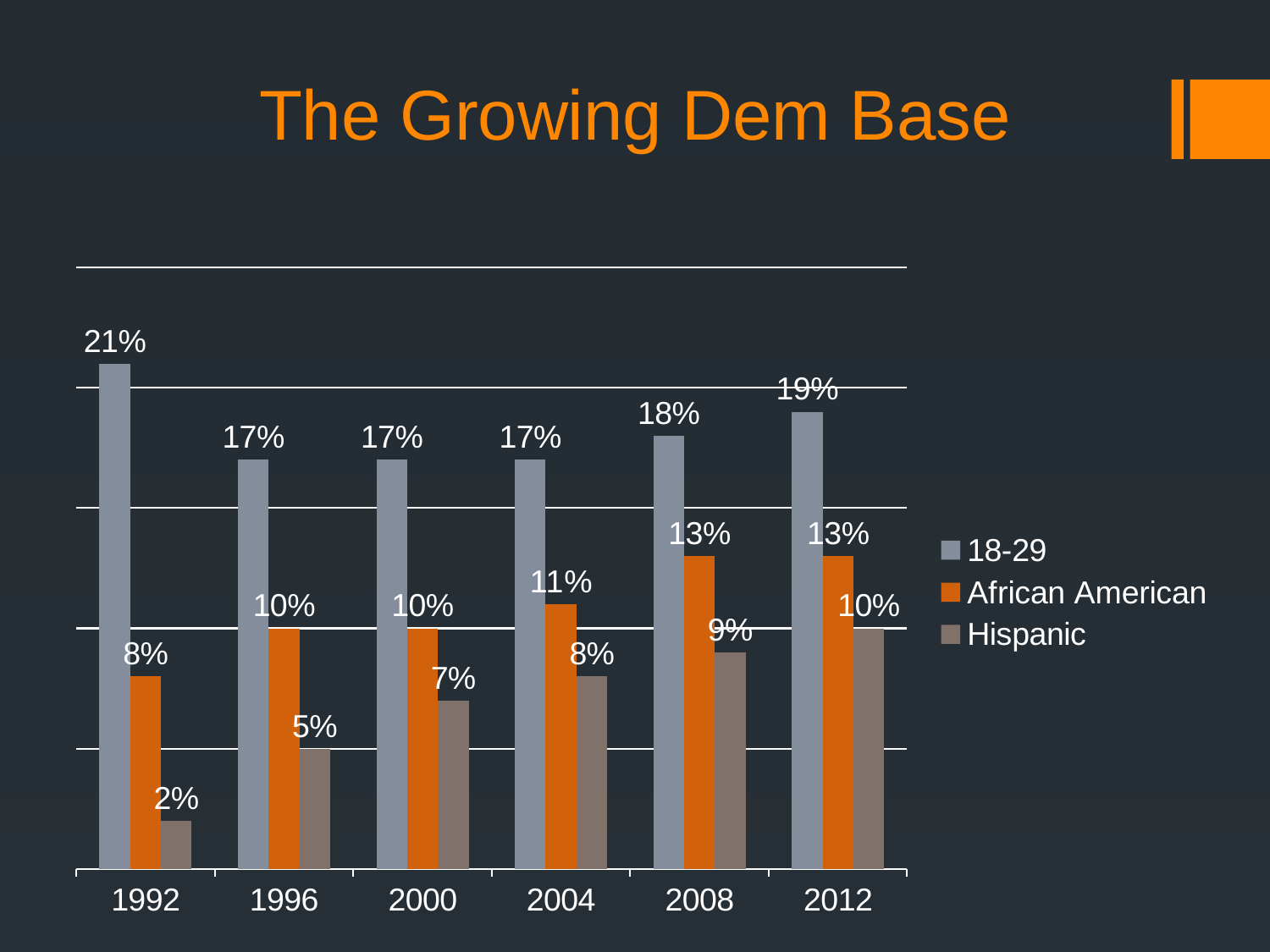
What kind of chart is shown on the slide? Bar chart What is the title of the slide? The Growing Dem Base What is the value for the 18-29 series in 1992? 21% What is the value for Hispanic in 2012? 10% In which year is the Hispanic value lowest? 1992 Does the Hispanic value rise or fall from 1992 to 2012? Rise What is the value for African American in 2004? 11% How many series does the legend list? 3 What is the difference between the 18-29 value and the Hispanic value in 1992? 19% In which year is the 18-29 value highest? 1992 How many years are shown on the x axis? 6 Which is larger in 2008: the African American value or the Hispanic value? African American